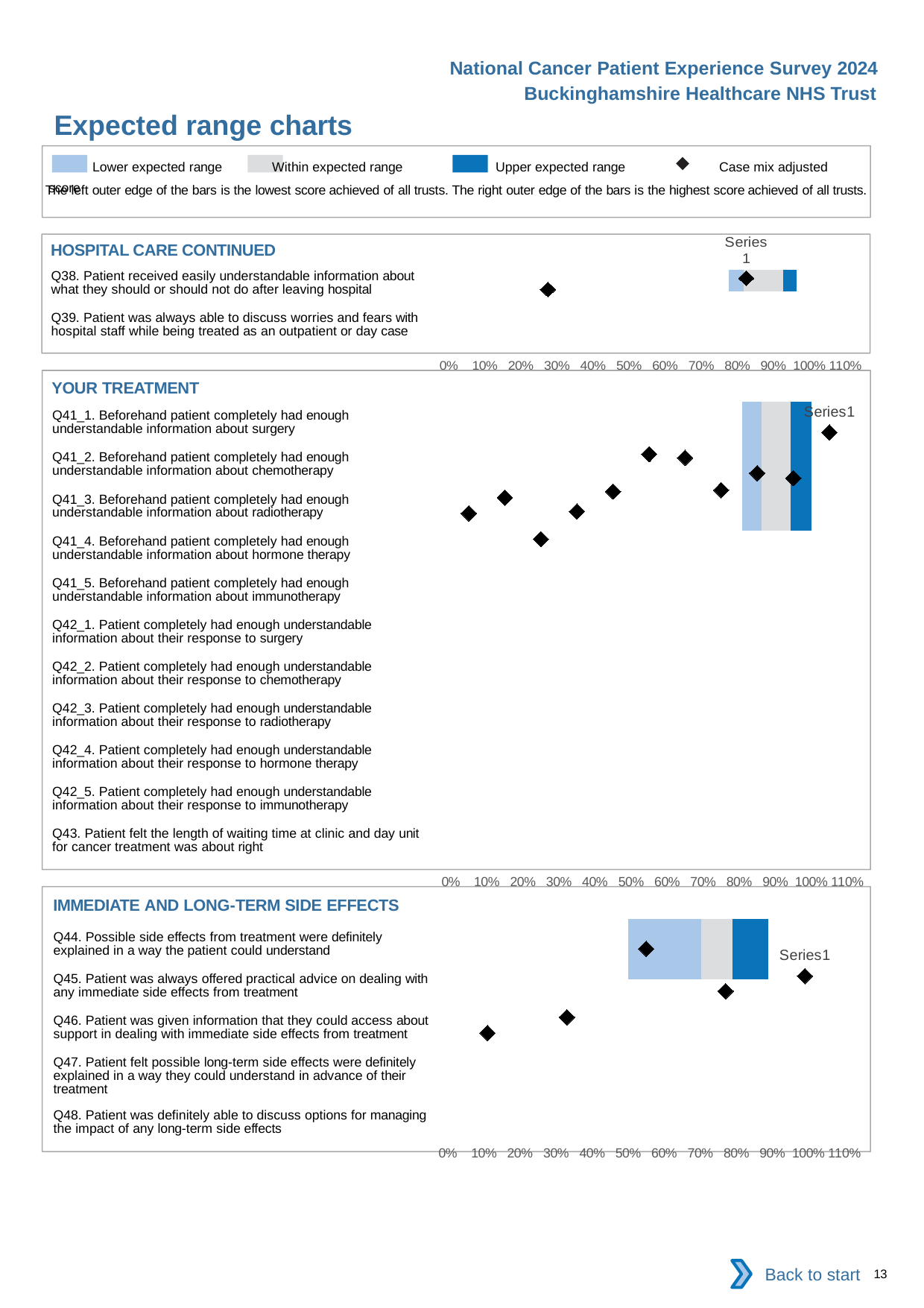
What is the lowest percentage tick shown on the x axis of the IMMEDIATE AND LONG-TERM SIDE EFFECTS chart? 0% What does the diamond marker represent according to the legend at the top of the slide? Case mix adjusted score In the IMMEDIATE AND LONG-TERM SIDE EFFECTS chart, does the left edge of the expected range bar sit at a value greater or less than 40%? greater What is the title of the first chart section on the slide? HOSPITAL CARE CONTINUED What is the highest percentage tick shown on the x axis of the YOUR TREATMENT chart? 110% How many questions are listed in the HOSPITAL CARE CONTINUED chart? 2 How many questions are listed in the YOUR TREATMENT chart? 11 How many questions are listed in the IMMEDIATE AND LONG-TERM SIDE EFFECTS chart? 5 What kind of chart is used in the IMMEDIATE AND LONG-TERM SIDE EFFECTS section? Bar chart In the YOUR TREATMENT chart, does the right edge of the expected range bar sit at a value greater or less than 90%? greater